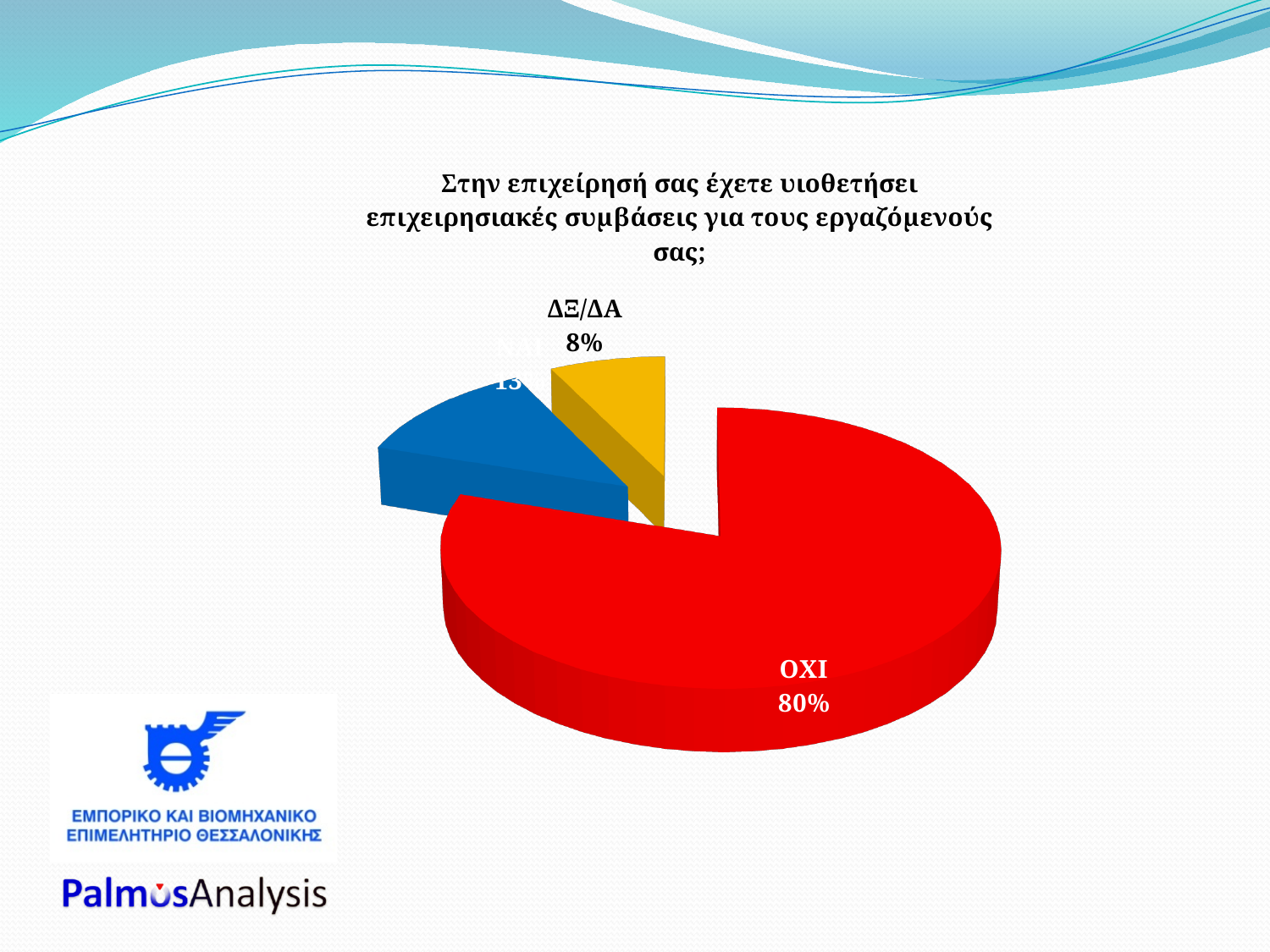
Which is larger, the ΟΧΙ slice or the ΔΞ/ΔΑ slice? ΟΧΙ Which category has the largest slice of the pie? ΟΧΙ What percentage is shown for the ΔΞ/ΔΑ slice? 8% What share of the pie does the ΟΧΙ slice represent? 80% What colour is the ΔΞ/ΔΑ slice? Yellow Which category has the smallest slice of the pie? ΔΞ/ΔΑ How many slices does the pie chart have? 3 What is the difference in percentage points between the ΟΧΙ slice and the ΔΞ/ΔΑ slice? 72 percentage points What colour is the ΟΧΙ slice? Red What kind of chart is shown on the slide? Pie chart What percentage is shown for the ΟΧΙ slice? 80%